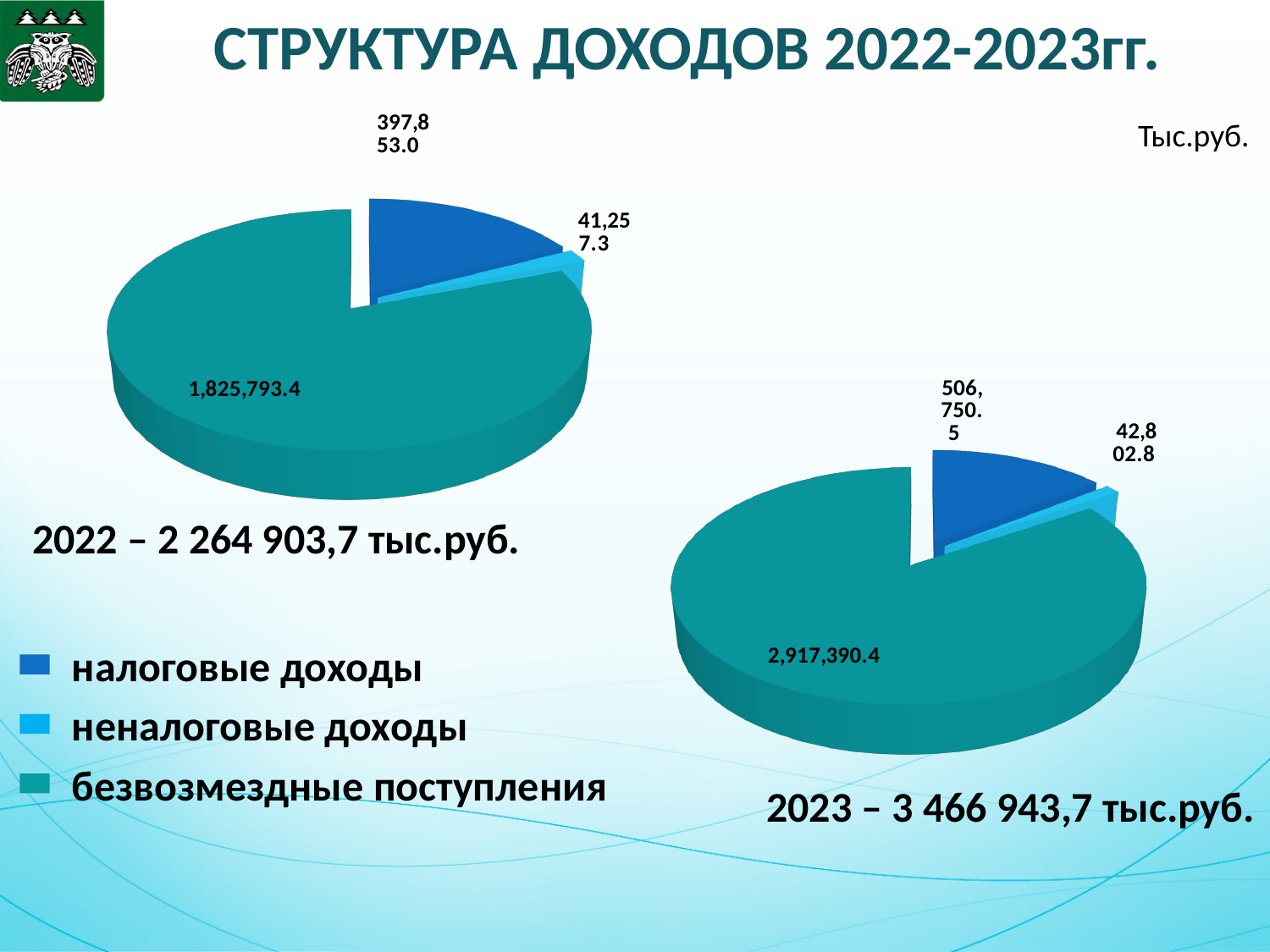
What total income is stated for 2023 on the slide? 3 466 943,7 тыс.руб. How many slices does the 2023 pie chart (right) have? 3 How many series does the legend list? 3 In the 2022 pie chart (left), what is the value for налоговые доходы? 397,853.0 Which is larger: безвозмездные поступления in the 2022 chart or in the 2023 chart? 2023 In the 2023 pie chart (right), what is the value for неналоговые доходы? 42,802.8 What is the difference between безвозмездные поступления in the 2023 chart and in the 2022 chart? 1,091,597.0 In the 2022 pie chart (left), what is the value for безвозмездные поступления? 1,825,793.4 In the 2022 pie chart (left), which category has the largest slice? безвозмездные поступления In the 2023 pie chart (right), which category has the smallest slice? неналоговые доходы What kind of chart is used on this slide for the 2022 and 2023 income structure? Pie chart In the 2023 pie chart (right), what is the value for безвозмездные поступления? 2,917,390.4